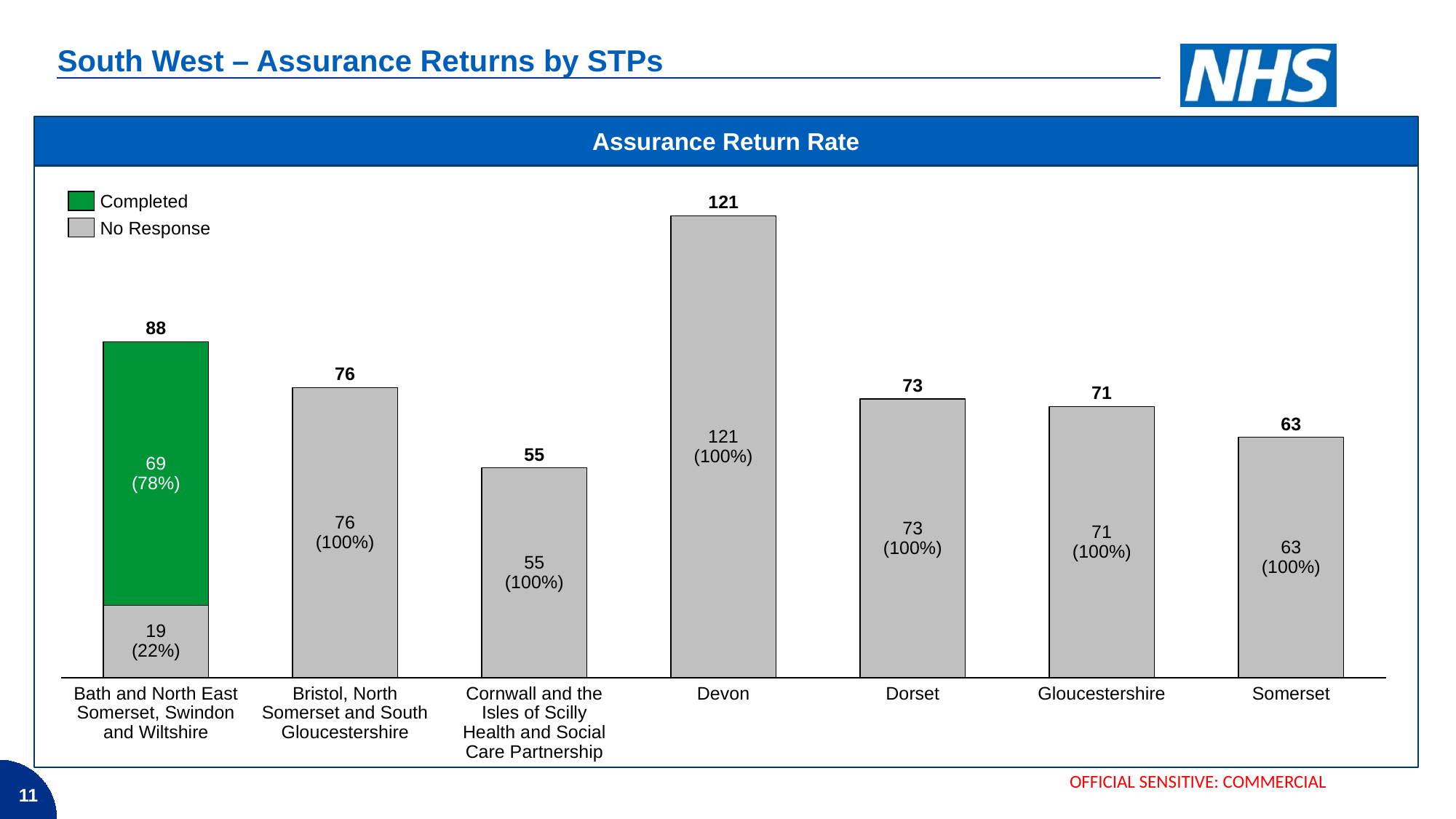
What is the difference between the total for Devon and the total for Somerset? 58 What is the total of the stacked bar for Bath and North East Somerset, Swindon and Wiltshire? 88 Which colour represents Completed in the legend? Green What kind of chart is shown? Stacked bar chart Which STP has the lowest total bar? Cornwall and the Isles of Scilly Health and Social Care Partnership Which STP has the highest total bar? Devon Which has a larger total, Dorset or Gloucestershire? Dorset What is the Completed value for Bath and North East Somerset, Swindon and Wiltshire? 69 (78%) How many series does the legend list? 2 How many STPs are shown on the x axis? 7 What is the total value shown above the bar for Devon? 121 What is the No Response value for Bath and North East Somerset, Swindon and Wiltshire? 19 (22%)